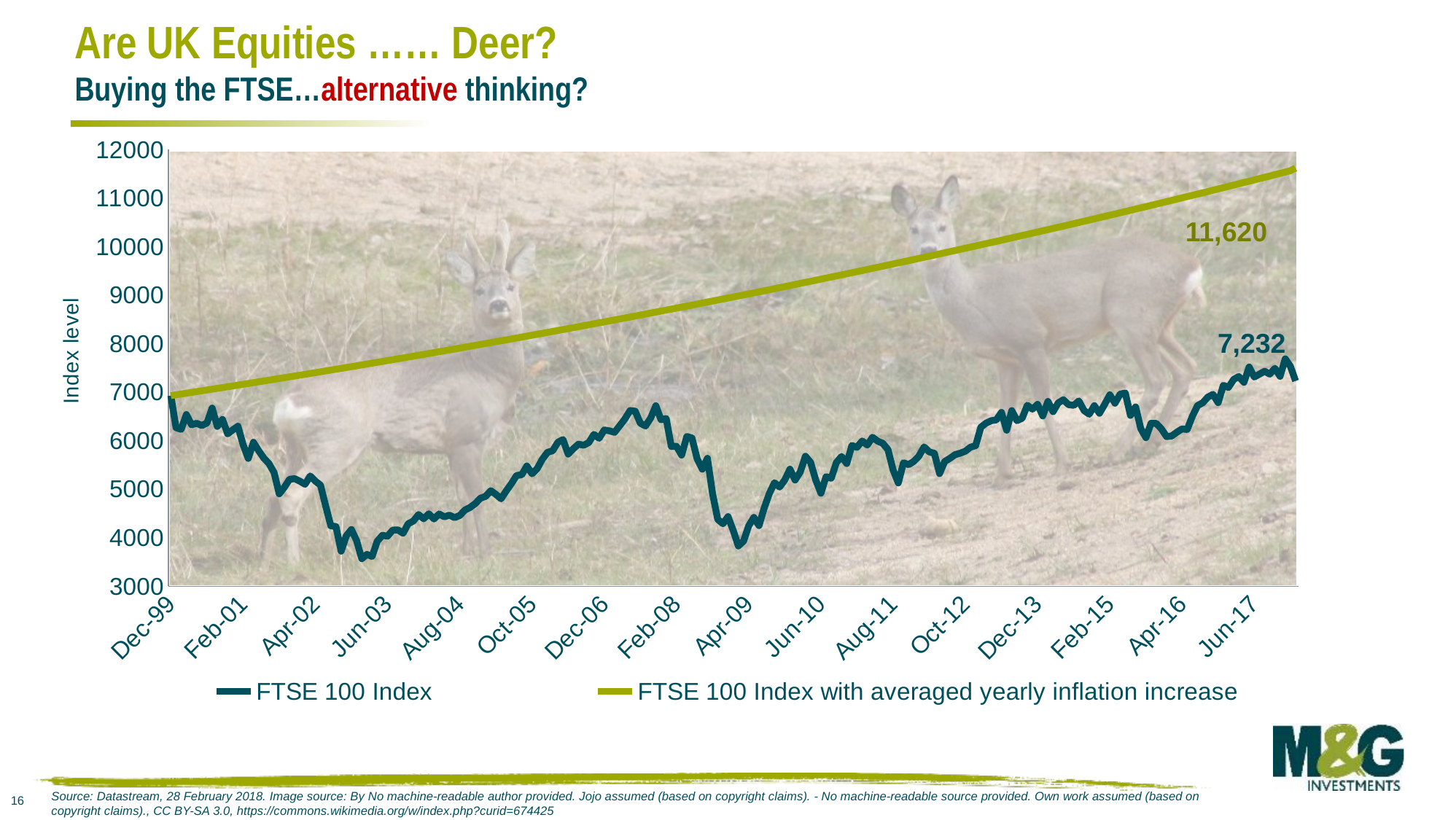
How many date labels are shown along the x axis? 16 Is the FTSE 100 Index value around Jun-03 greater or less than 5000? less How many series does the chart legend list? 2 Is the FTSE 100 Index with averaged yearly inflation increase value at Dec-99 greater or less than 8000? less What is the labelled end value of the FTSE 100 Index with averaged yearly inflation increase line? 11,620 Is the FTSE 100 Index value around Apr-09 greater or less than 5000? less What is the labelled end value of the FTSE 100 Index line? 7,232 At the end of the chart, which line is higher: the FTSE 100 Index or the FTSE 100 Index with averaged yearly inflation increase? FTSE 100 Index with averaged yearly inflation increase What kind of chart is shown on the slide? line chart Does the FTSE 100 Index with averaged yearly inflation increase line rise or fall from Dec-99 to Jun-17? rise What is the difference between the labelled end values of the two lines (11,620 and 7,232)? 4,388 What is the title of the vertical axis? Index level